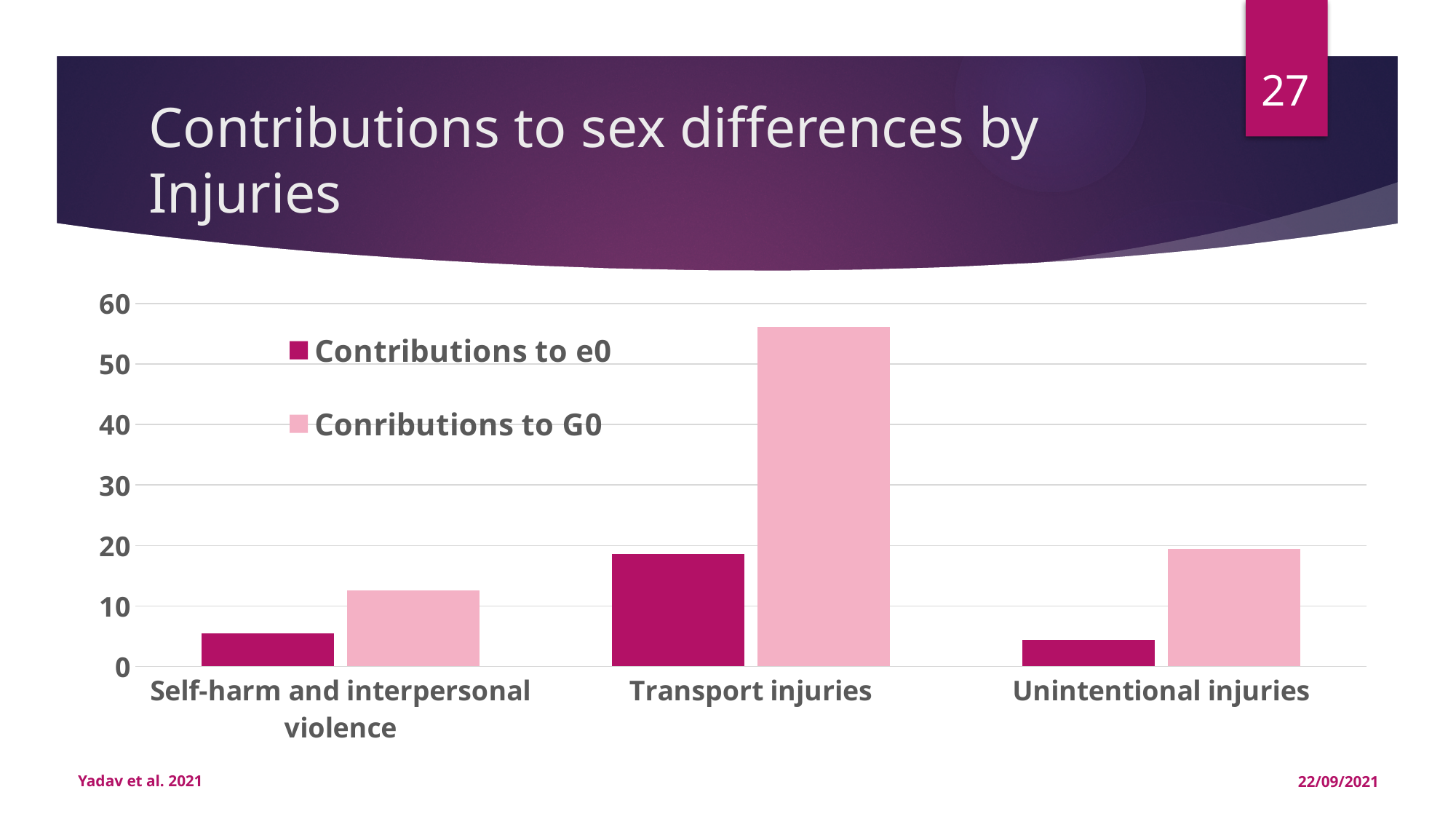
How many series does the legend list? 2 What kind of chart is shown on the slide? bar chart How many injury categories are shown on the x axis? 3 Is the Contributions to e0 value for Transport injuries greater or less than 20? less What is the title of the slide containing the chart? Contributions to sex differences by Injuries Is the Conributions to G0 value for Transport injuries greater or less than 50? greater Is the Conributions to G0 value for Self-harm and interpersonal violence greater or less than 10? greater Which category has the highest value for Contributions to e0? Transport injuries Which category has the lowest value for Conributions to G0? Self-harm and interpersonal violence Which category has the highest value for Conributions to G0? Transport injuries For Transport injuries, which is larger: Contributions to e0 or Conributions to G0? Conributions to G0